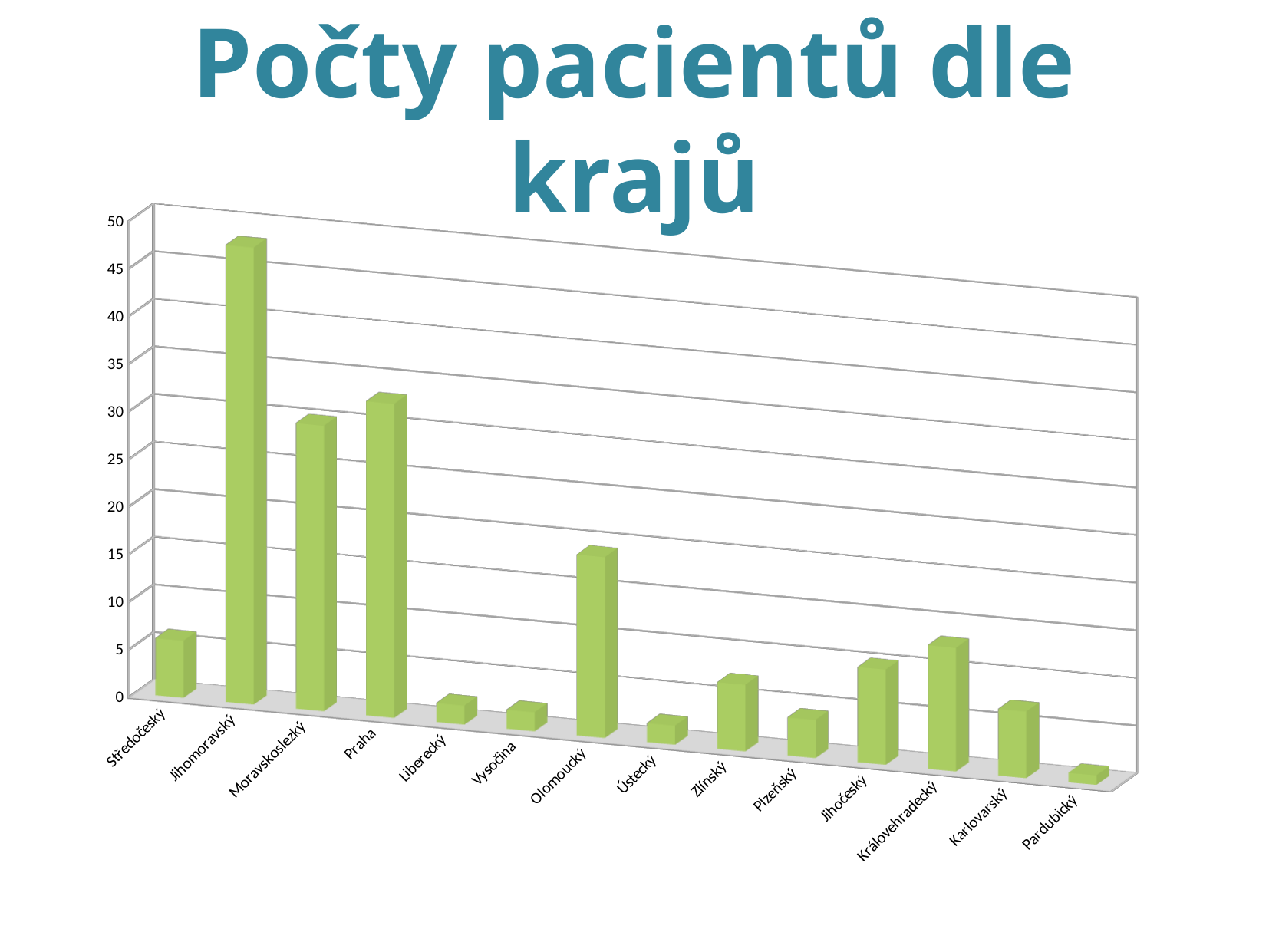
Which has more patients, Jihomoravský or Praha? Jihomoravský What colour are the bars in the chart? green Which region has the highest number of patients? Jihomoravský Is the value for Olomoucký greater or less than 10? greater Is the value for Středočeský greater or less than 10? less How many regions (categories) are shown on the x axis of the chart? 14 Is the value for Olomoucký greater or less than 20? less What kind of chart is shown on the slide? bar chart Which region has the lowest number of patients? Pardubický What is the title of the chart? Počty pacientů dle krajů Which has more patients, Olomoucký or Středočeský? Olomoucký